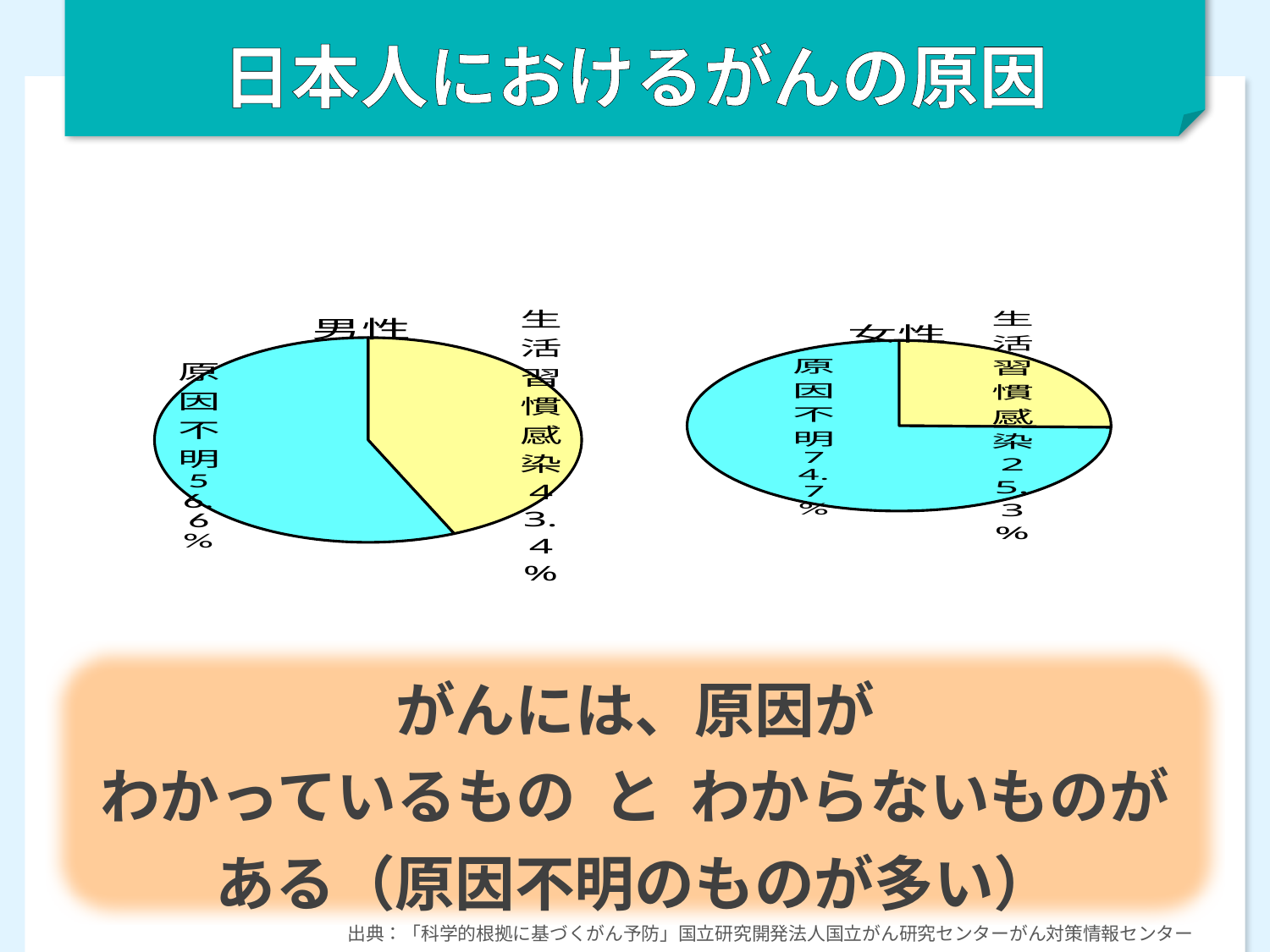
What type of chart is used for 男性 on this slide? Pie chart In the 女性 pie chart, what percentage is labelled for 原因不明? 74.7% In the 男性 pie chart, which slice is the largest? 原因不明 How many slices does the 女性 pie chart have? 2 In the 男性 pie chart, what is the difference between the 原因不明 and 生活習慣感染 percentages? 13.2% In the 女性 pie chart, which slice is the smallest? 生活習慣感染 In the 女性 pie chart, what is the difference between the 原因不明 and 生活習慣感染 percentages? 49.4% In the 男性 pie chart, what percentage is labelled for 原因不明? 56.6% What colour is the 原因不明 slice in the 男性 pie chart? Cyan (light blue) In the 男性 pie chart, what percentage is labelled for 生活習慣感染? 43.4% In the 女性 pie chart, what percentage is labelled for 生活習慣感染? 25.3% Which is larger: the 生活習慣感染 share in the 男性 chart or in the 女性 chart? 男性